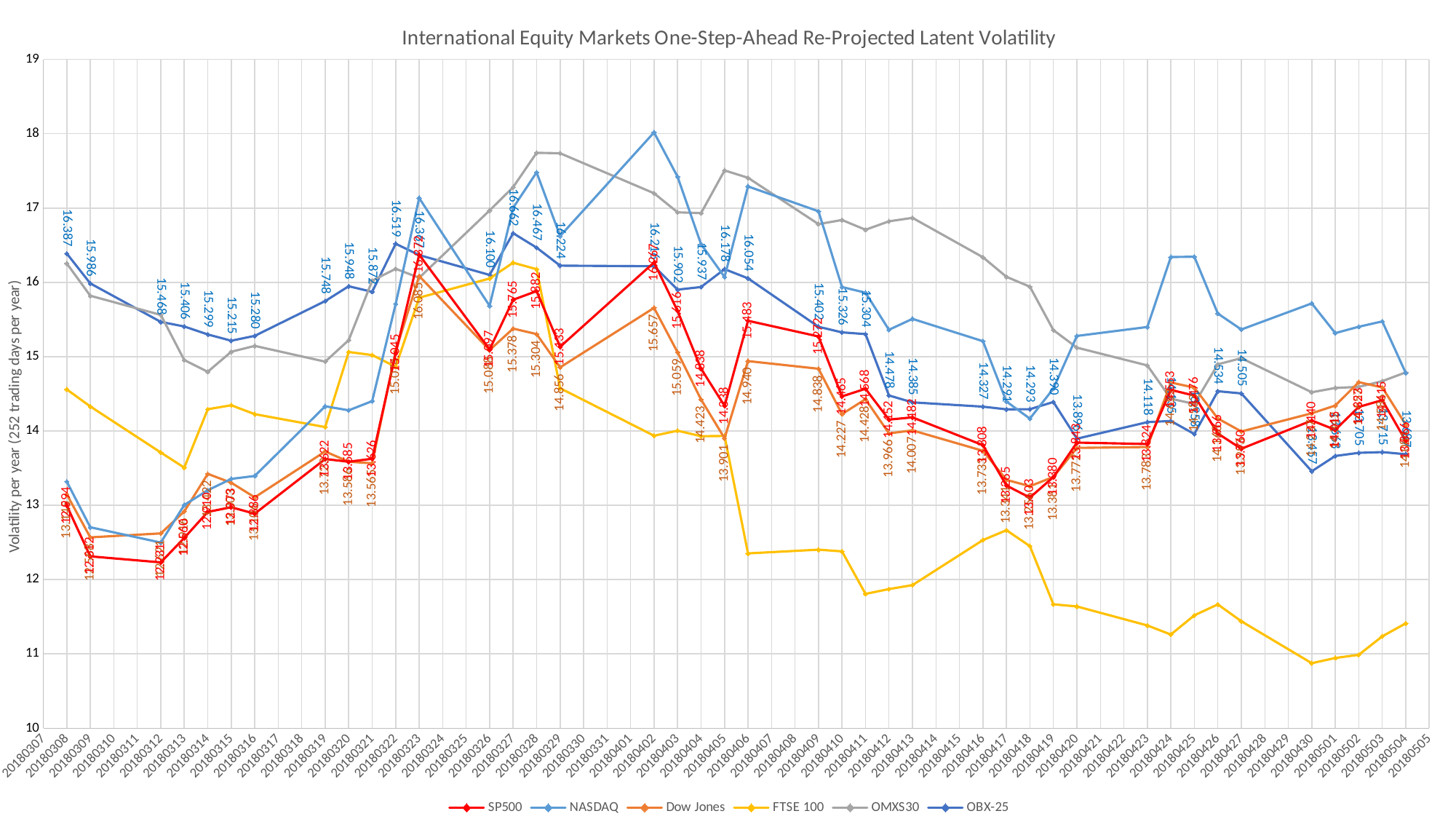
What kind of chart is shown on the slide? line chart What is the OBX-25 value on 20180322? 16.519 What is the OBX-25 value on 20180308? 16.387 Which series has the lowest value on 20180411? FTSE 100 Is the NASDAQ value on 20180402 greater or less than 17? greater What is the Dow Jones value on 20180402? 15.657 Is the FTSE 100 value on 20180430 greater or less than 11? less Does the OBX-25 series rise or fall between 20180322 and 20180418? fall What is the difference between the OBX-25 values on 20180308 and 20180309? 0.401 What is the title of the chart? International Equity Markets One-Step-Ahead Re-Projected Latent Volatility Which series has the highest value on 20180402? NASDAQ How many series does the legend list? 6